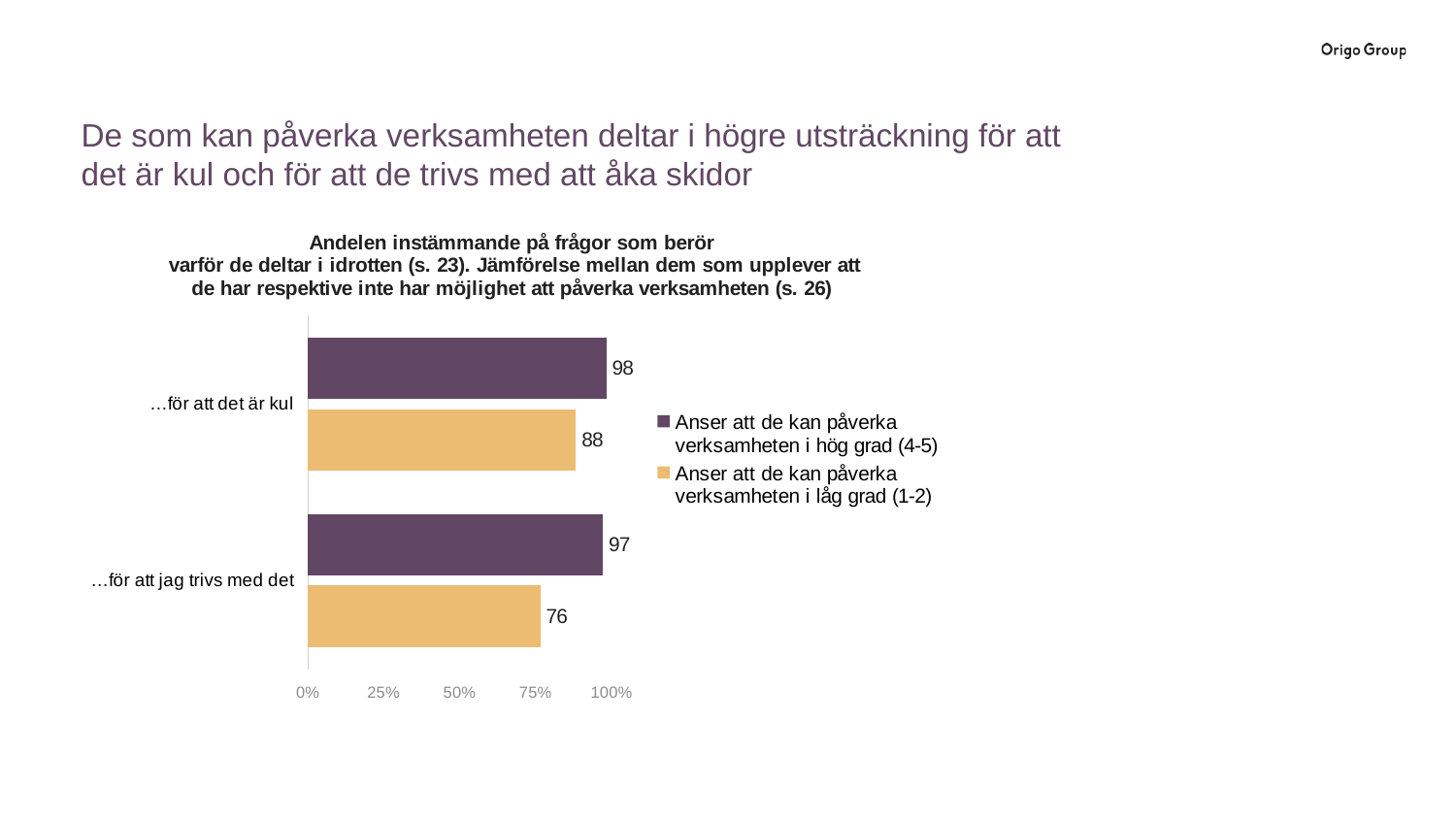
What is the value for "…för att jag trivs med det" in the series "Anser att de kan påverka verksamheten i låg grad (1-2)"? 76 What is the difference between the two series for "…för att det är kul"? 10 How many series does the legend list? 2 What is the value for "…för att jag trivs med det" in the series "Anser att de kan påverka verksamheten i hög grad (4-5)"? 97 Is the value for "…för att jag trivs med det" in the "låg grad (1-2)" series greater or less than 75%? greater What is the value for "…för att det är kul" in the series "Anser att de kan påverka verksamheten i hög grad (4-5)"? 98 What is the difference between the two series for "…för att jag trivs med det"? 21 For the series "Anser att de kan påverka verksamheten i låg grad (1-2)", which category has the larger value: "…för att det är kul" or "…för att jag trivs med det"? …för att det är kul What kind of chart is shown on the slide? Bar chart Which bar has the lowest value on the chart? …för att jag trivs med det, Anser att de kan påverka verksamheten i låg grad (1-2) How many categories are shown on the chart? 2 What is the value for "…för att det är kul" in the series "Anser att de kan påverka verksamheten i låg grad (1-2)"? 88